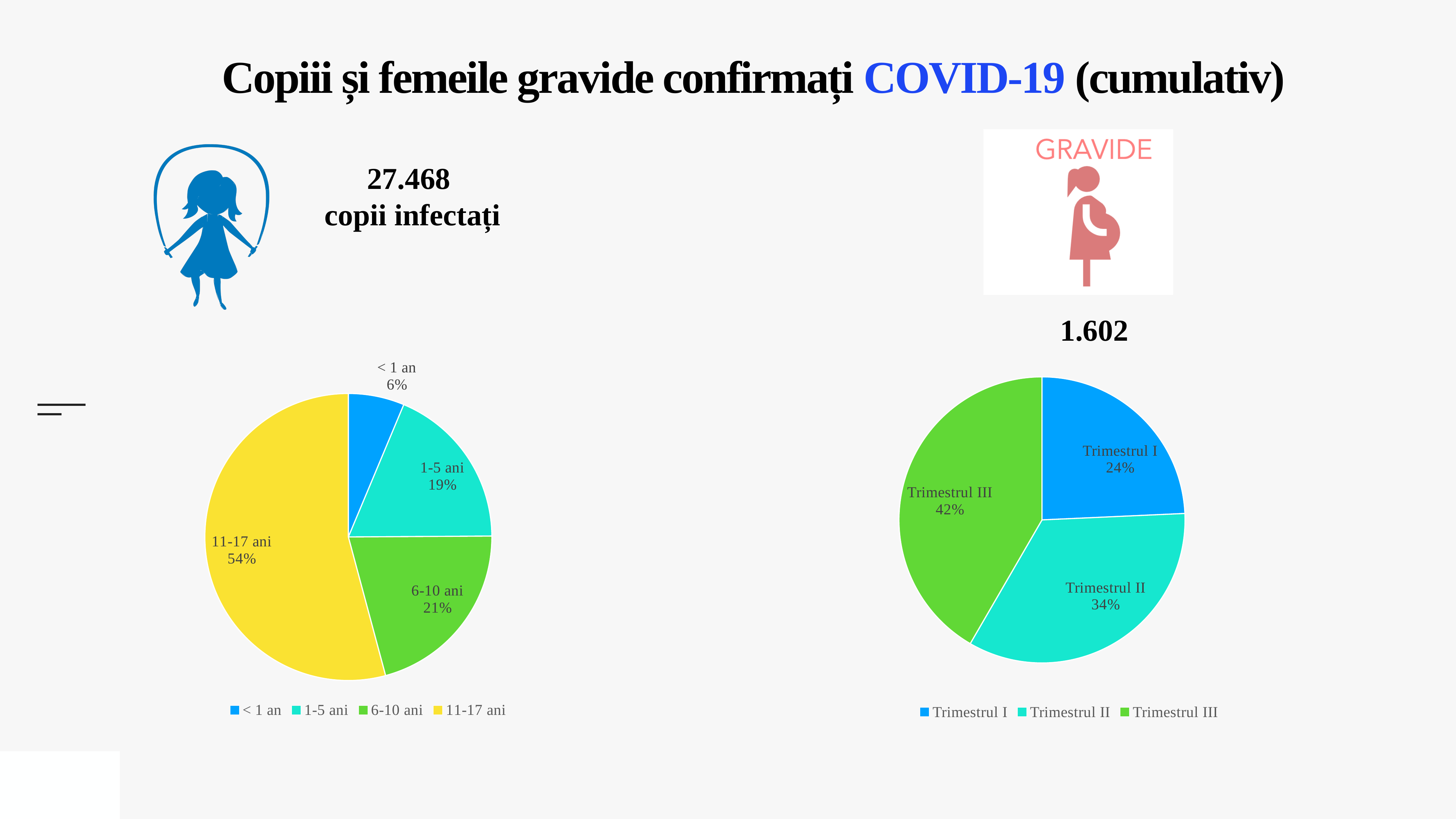
In the left pie chart (children by age group), which age group has the smallest share? < 1 an What type of chart is the right chart (pregnant women by trimester)? Pie chart In the left pie chart (children by age group), which age group has the largest share? 11-17 ani In the right pie chart (pregnant women by trimester), how many entries does the legend list? 3 In the left pie chart (children by age group), what share is labelled for 11-17 ani? 54% In the left pie chart (children by age group), what share is labelled for < 1 an? 6% In the right pie chart (pregnant women by trimester), what is the difference in percentage points between Trimestrul III and Trimestrul I? 18 In the right pie chart (pregnant women by trimester), which trimester has the largest share? Trimestrul III In the left pie chart (children by age group), how many age groups are shown? 4 In the right pie chart (pregnant women by trimester), which is larger, Trimestrul I or Trimestrul II? Trimestrul II In the left pie chart (children by age group), what is the difference in percentage points between 6-10 ani and 1-5 ani? 2 In the right pie chart (pregnant women by trimester), what share is labelled for Trimestrul II? 34%